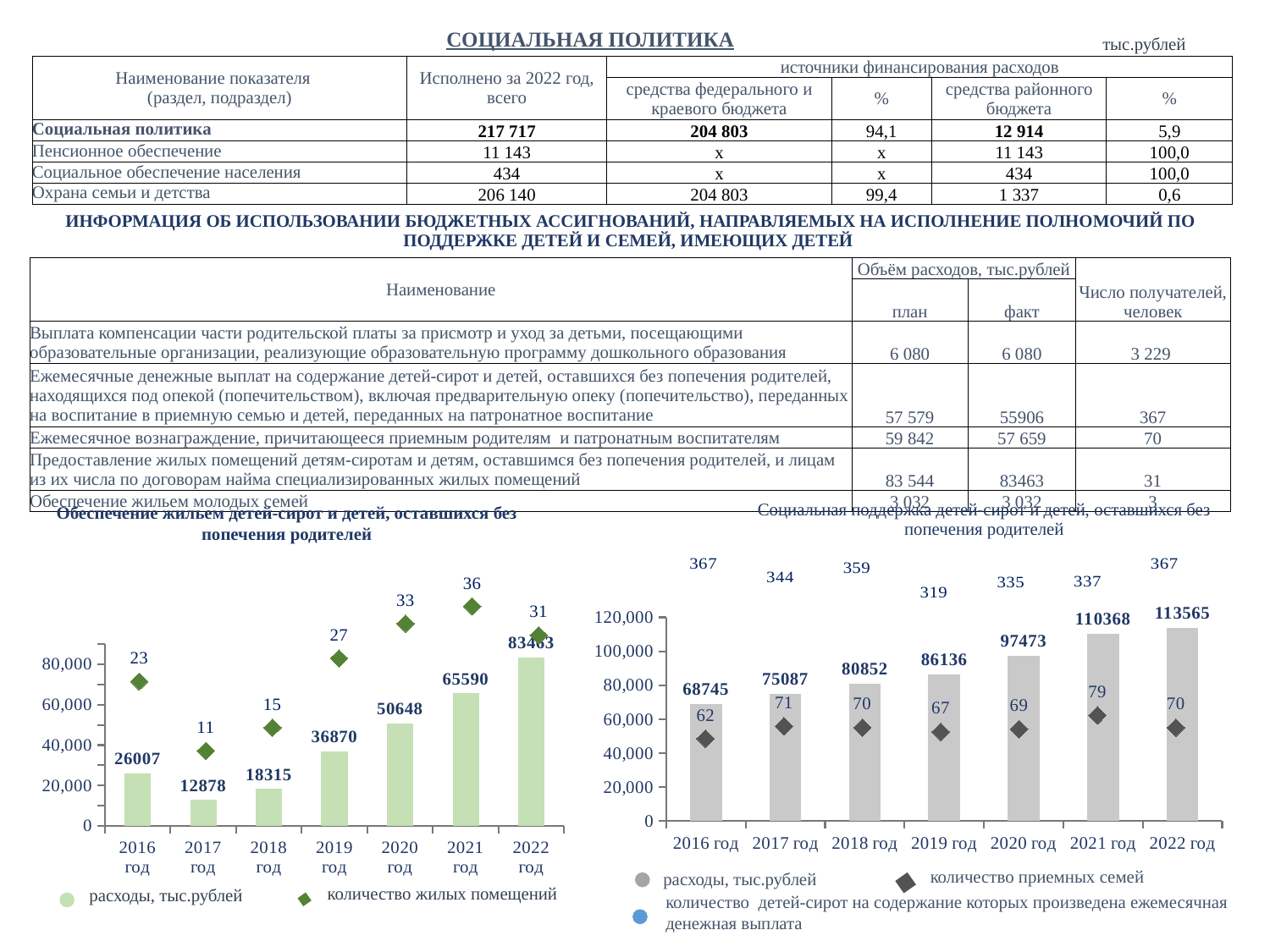
In the right chart 'Социальная поддержка детей-сирот и детей, оставшихся без попечения родителей', how many series does the legend list? 3 In the left chart 'Обеспечение жильем детей-сирот и детей, оставшихся без попечения родителей', which year has the lowest расходы, тыс.рублей? 2017 год In the left chart 'Обеспечение жильем детей-сирот и детей, оставшихся без попечения родителей', what is the difference in расходы, тыс.рублей between 2022 год and 2021 год? 17873 In the right chart 'Социальная поддержка детей-сирот и детей, оставшихся без попечения родителей', which year has the highest расходы, тыс.рублей? 2022 год In the right chart 'Социальная поддержка детей-сирот и детей, оставшихся без попечения родителей', what is the value of расходы, тыс.рублей for 2019 год? 86136 In the right chart 'Социальная поддержка детей-сирот и детей, оставшихся без попечения родителей', do the расходы, тыс.рублей values rise or fall from 2016 год to 2022 год? rise In the right chart 'Социальная поддержка детей-сирот и детей, оставшихся без попечения родителей', what is the количество приемных семей for 2021 год? 79 In the right chart 'Социальная поддержка детей-сирот и детей, оставшихся без попечения родителей', which is larger: расходы, тыс.рублей for 2017 год or for 2018 год? 2018 год In the left chart 'Обеспечение жильем детей-сирот и детей, оставшихся без попечения родителей', what is the value of расходы, тыс.рублей for 2020 год? 50648 In the left chart 'Обеспечение жильем детей-сирот и детей, оставшихся без попечения родителей', how many years are shown on the x axis? 7 What kind of chart is the left chart 'Обеспечение жильем детей-сирот и детей, оставшихся без попечения родителей'? bar chart with markers In the left chart 'Обеспечение жильем детей-сирот и детей, оставшихся без попечения родителей', what is the количество жилых помещений for 2021 год? 36